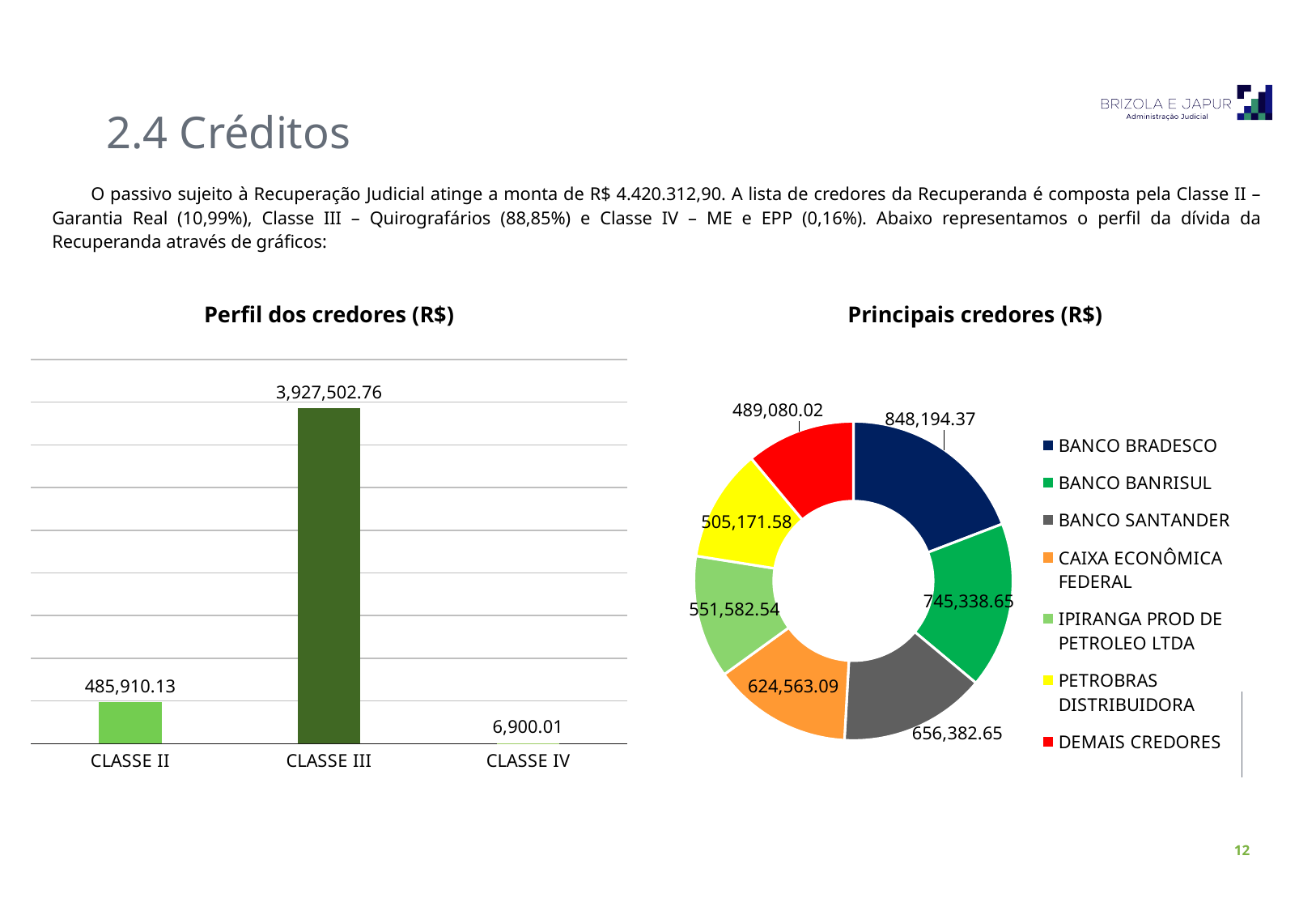
In the 'Principais credores (R$)' chart, which is larger: CAIXA ECONÔMICA FEDERAL or IPIRANGA PROD DE PETROLEO LTDA? CAIXA ECONÔMICA FEDERAL In the 'Principais credores (R$)' chart, what is the value for BANCO SANTANDER? 656,382.65 How many entries does the legend of the 'Principais credores (R$)' chart list? 7 In the 'Perfil dos credores (R$)' chart, what is the value for CLASSE III? 3,927,502.76 In the 'Perfil dos credores (R$)' chart, what is the difference between CLASSE III and CLASSE II? 3,441,592.63 In the 'Principais credores (R$)' chart, what is the difference between BANCO BRADESCO and BANCO BANRISUL? 102,855.72 In the 'Principais credores (R$)' chart, what is the value for PETROBRAS DISTRIBUIDORA? 505,171.58 In the 'Principais credores (R$)' chart, which creditor has the largest value? BANCO BRADESCO What kind of chart is 'Perfil dos credores (R$)'? Bar chart In the 'Perfil dos credores (R$)' chart, which class has the lowest value? CLASSE IV In the 'Perfil dos credores (R$)' chart, what is the value for CLASSE II? 485,910.13 In the 'Perfil dos credores (R$)' chart, how many classes are shown on the x axis? 3